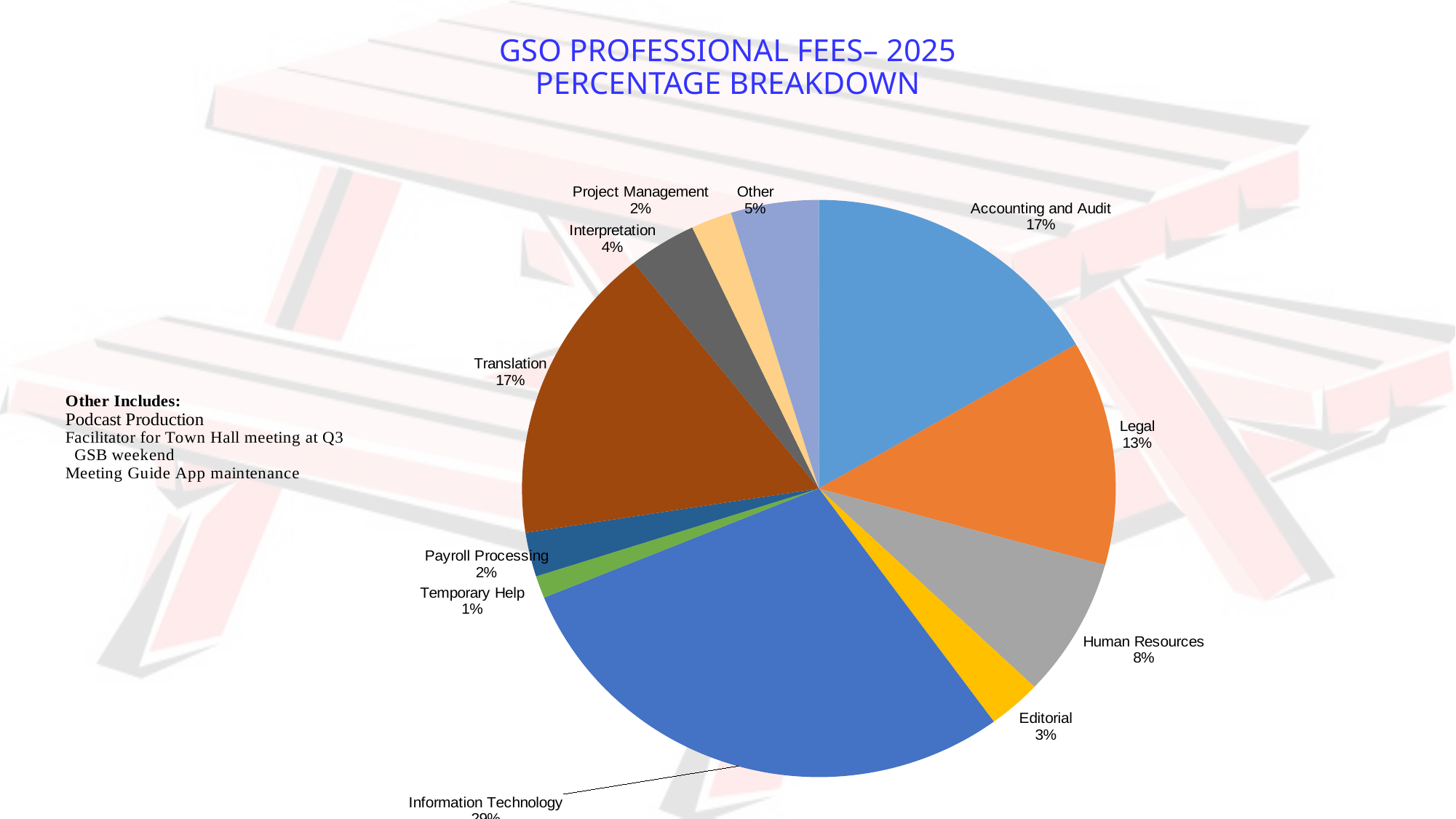
What is the difference in percentage points between Accounting and Audit and Legal? 4 What kind of chart is shown on the slide? pie chart What share of the pie is Human Resources? 8% How many categories are shown in the pie chart? 11 Which category has the largest share of the pie? Information Technology What percentage of GSO professional fees is Legal? 13% Which category has the smallest share of the pie? Temporary Help Which is larger, the share for Other or the share for Interpretation? Other What is the title of the chart? GSO PROFESSIONAL FEES– 2025 PERCENTAGE BREAKDOWN What percentage is shown for Translation? 17% What percentage is shown for Editorial? 3% What percentage is shown for Interpretation? 4%